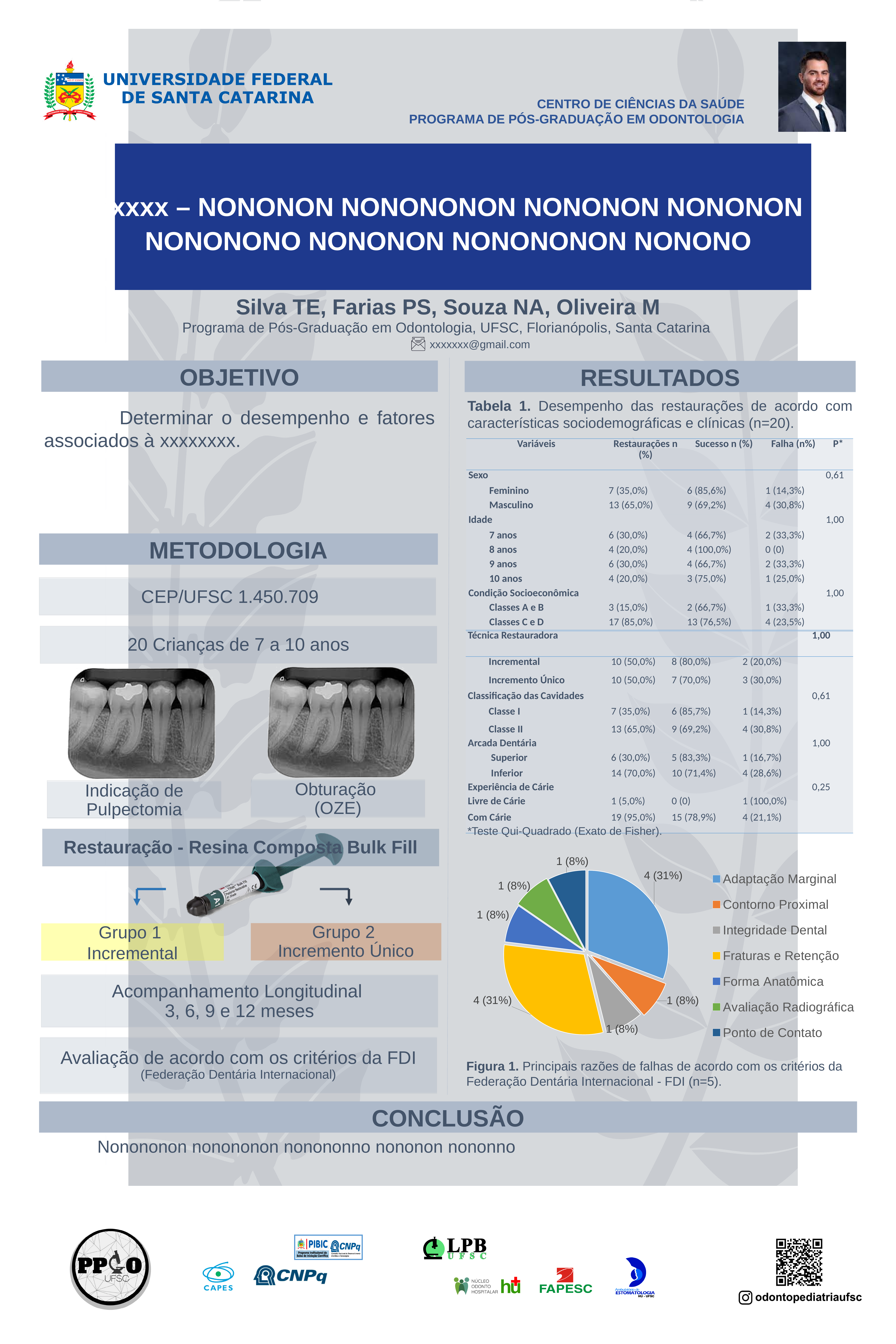
What share of the pie does Ponto de Contato represent? 8% Which legend entry of the pie chart is shown in yellow? Fraturas e Retenção In the pie chart, what is the difference in count between Adaptação Marginal and Forma Anatômica? 3 In the pie chart, what is the data label for Fraturas e Retenção? 4 (31%) How many entries does the legend of the pie chart list? 7 How many slices does the pie chart in Figura 1 have? 7 What kind of chart is shown in Figura 1 on the slide? pie chart In the pie chart, what is the data label for Adaptação Marginal? 4 (31%) According to the caption, what is the sample size (n) for Figura 1? n=5 In the pie chart, what is the data label for Contorno Proximal? 1 (8%) In the pie chart, which is larger: Fraturas e Retenção or Integridade Dental? Fraturas e Retenção What share of the pie does Adaptação Marginal represent? 31%